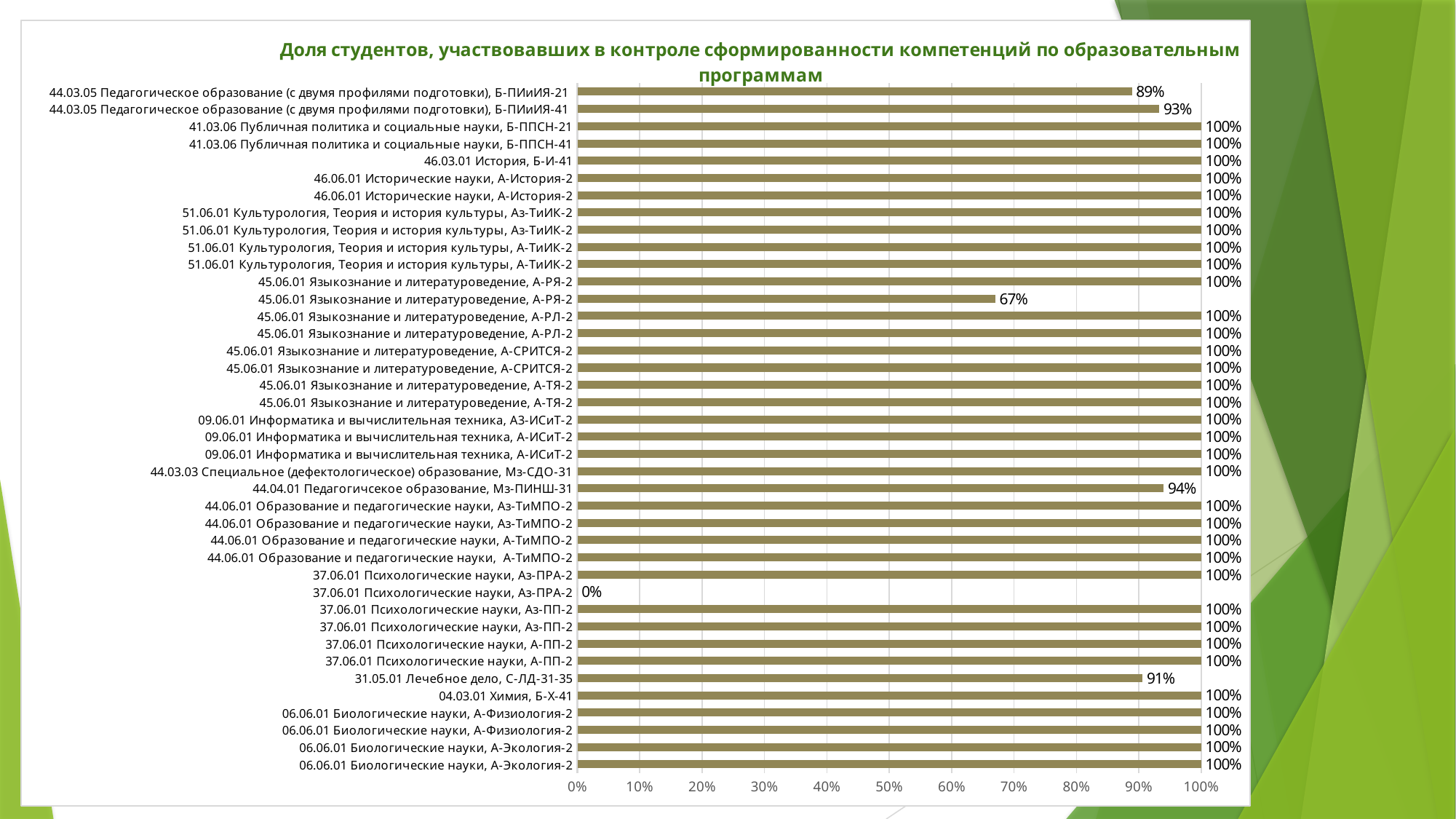
What is the difference between the values for Б-ПИиИЯ-41 and Б-ПИиИЯ-21? 4% Which category has the lowest value in the chart? 37.06.01 Психологические науки, Аз-ПРА-2 What is the value for 44.04.01 Педагогичсекое образование, Мз-ПИНШ-31? 94% Which is larger: the value for 44.04.01 Педагогичсекое образование, Мз-ПИНШ-31 or for 31.05.01 Лечебное дело, С-ЛД-31-35? 44.04.01 Педагогичсекое образование, Мз-ПИНШ-31 What is the title of the chart? Доля студентов, участвовавших в контроле сформированности компетенций по образовательным программам What is the value for 04.03.01 Химия, Б-Х-41? 100% Is the value for 44.03.05 Педагогическое образование (с двумя профилями подготовки), Б-ПИиИЯ-21 greater or less than 80%? greater What type of chart is shown on the slide? bar chart What is the value for 44.03.05 Педагогическое образование (с двумя профилями подготовки), Б-ПИиИЯ-41? 93% What is the value for 31.05.01 Лечебное дело, С-ЛД-31-35? 91% What is the value for 44.03.05 Педагогическое образование (с двумя профилями подготовки), Б-ПИиИЯ-21? 89% How many bars are shown in the chart? 40